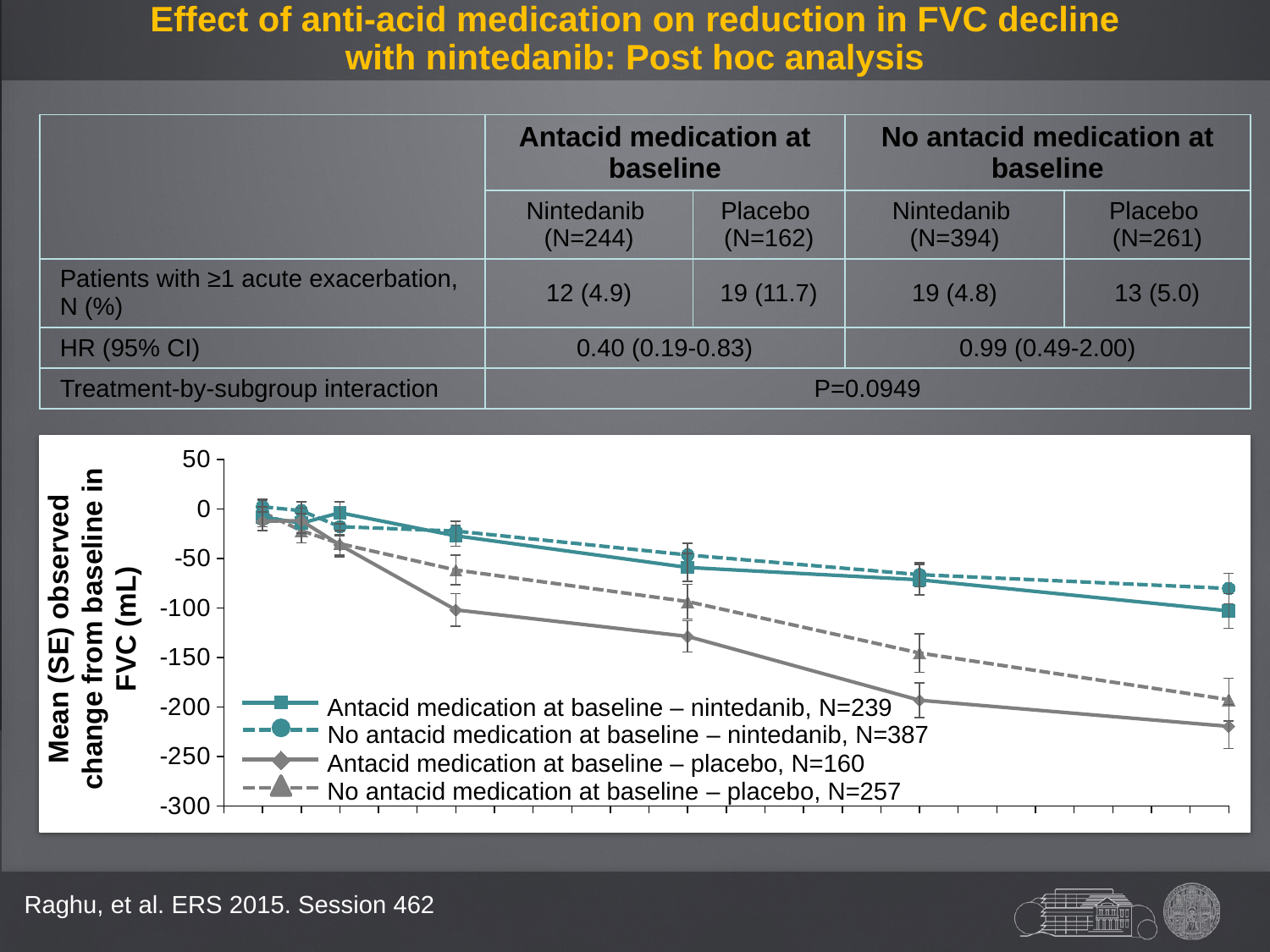
Do the values of the 'Antacid medication at baseline – placebo' series rise or fall along the x axis? fall How many series does the chart legend list? 4 Is the rightmost value for 'No antacid medication at baseline – nintedanib' greater or less than -50? less What kind of chart is shown on the slide? line chart Is the rightmost value for 'No antacid medication at baseline – nintedanib' greater or less than -100? greater Is the rightmost value for 'No antacid medication at baseline – placebo' greater or less than -150? less What is the label of the y axis of the chart? Mean (SE) observed change from baseline in FVC (mL) Which series has the highest value at the rightmost point of the chart? No antacid medication at baseline – nintedanib Which series has the lowest value at the rightmost point of the chart? Antacid medication at baseline – placebo At the rightmost point, which is higher: 'Antacid medication at baseline – nintedanib' or 'Antacid medication at baseline – placebo'? Antacid medication at baseline – nintedanib According to the legend, what is the N for the 'Antacid medication at baseline – placebo' series? N=160